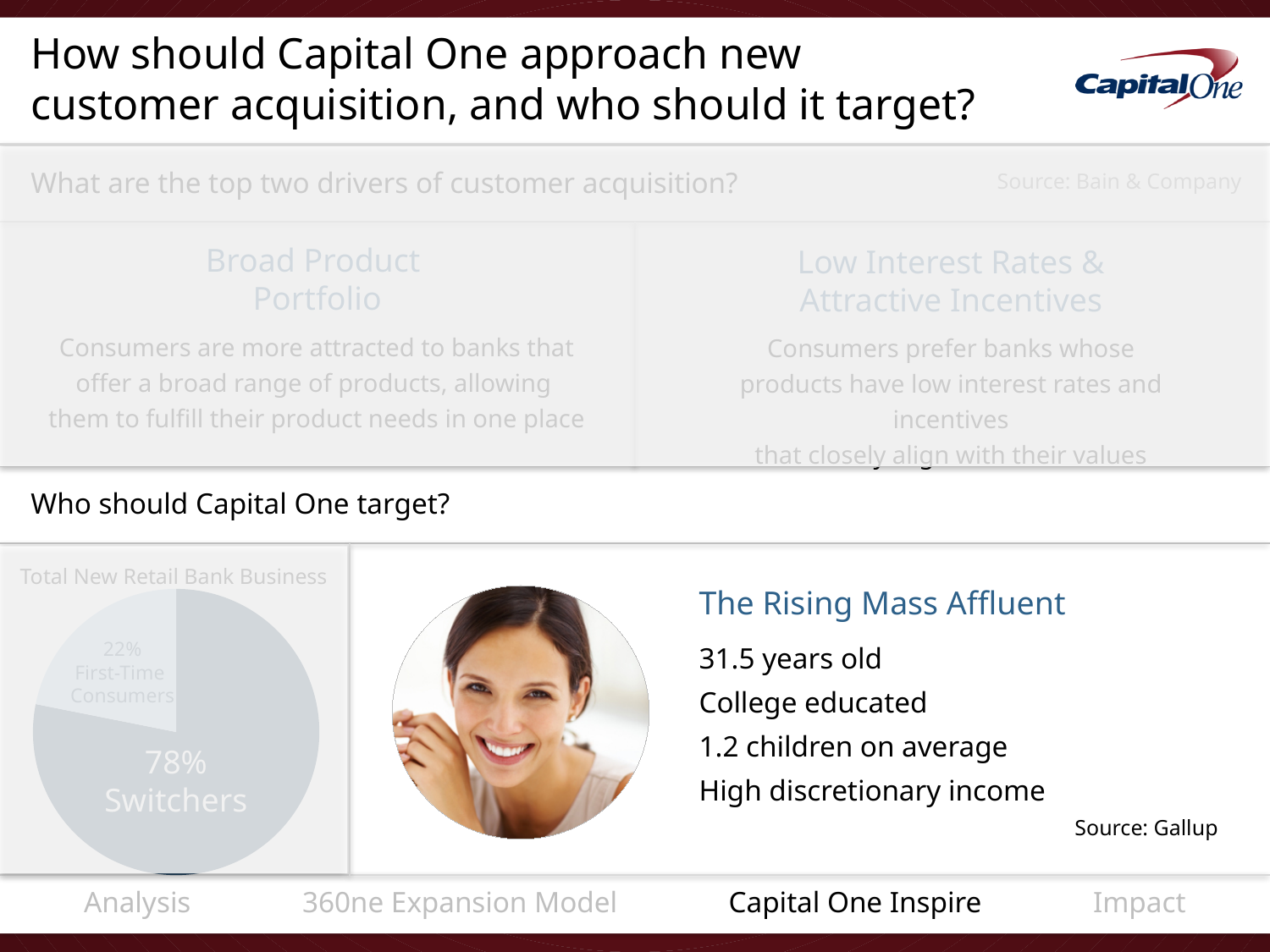
What kind of chart is shown under "Total New Retail Bank Business"? pie chart Is the share for Switchers in the Total New Retail Bank Business pie chart greater or less than 50%? greater What share of Total New Retail Bank Business is made up of First-Time Consumers? 22% How many slices does the Total New Retail Bank Business pie chart have? 2 In the Total New Retail Bank Business pie chart, which is larger: Switchers or First-Time Consumers? Switchers What share of Total New Retail Bank Business is made up of Switchers? 78% Which slice of the Total New Retail Bank Business pie chart is the largest? Switchers What is the title of the pie chart on the slide? Total New Retail Bank Business Which slice of the Total New Retail Bank Business pie chart is the smallest? First-Time Consumers What is the difference in percentage points between Switchers and First-Time Consumers in the Total New Retail Bank Business pie chart? 56